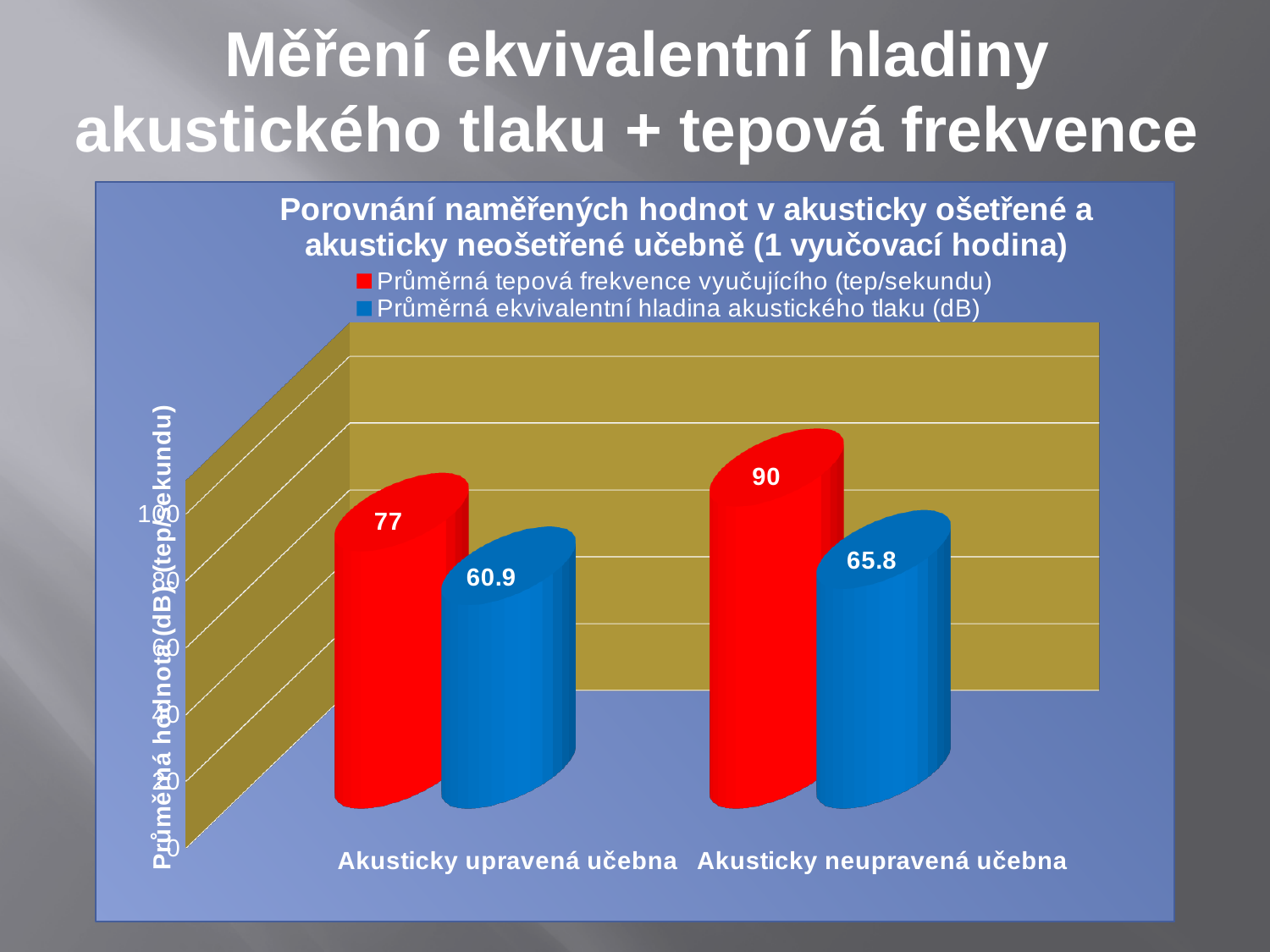
What is the average heart rate of the teacher (Průměrná tepová frekvence vyučujícího) in the acoustically treated classroom (Akusticky upravená učebna)? 77 What is the average heart rate of the teacher (Průměrná tepová frekvence vyučujícího) in the acoustically untreated classroom (Akusticky neupravená učebna)? 90 Which is larger: the sound pressure level in the treated classroom (60.9) or in the untreated classroom (65.8)? Akusticky neupravená učebna (65.8) What kind of chart is shown on the slide? Bar chart What is the difference in the teacher's average heart rate between the untreated and the treated classroom? 13 What is the difference in the average equivalent sound pressure level between the untreated and the treated classroom? 4.9 How many series does the legend list? 2 What is the average equivalent sound pressure level (Průměrná ekvivalentní hladina akustického tlaku) in the acoustically untreated classroom (Akusticky neupravená učebna)? 65.8 In which classroom is the average heart rate of the teacher higher? Akusticky neupravená učebna In which classroom is the average equivalent sound pressure level lower? Akusticky upravená učebna How many categories (classrooms) are shown on the x axis? 2 What is the average equivalent sound pressure level (Průměrná ekvivalentní hladina akustického tlaku) in the acoustically treated classroom (Akusticky upravená učebna)? 60.9